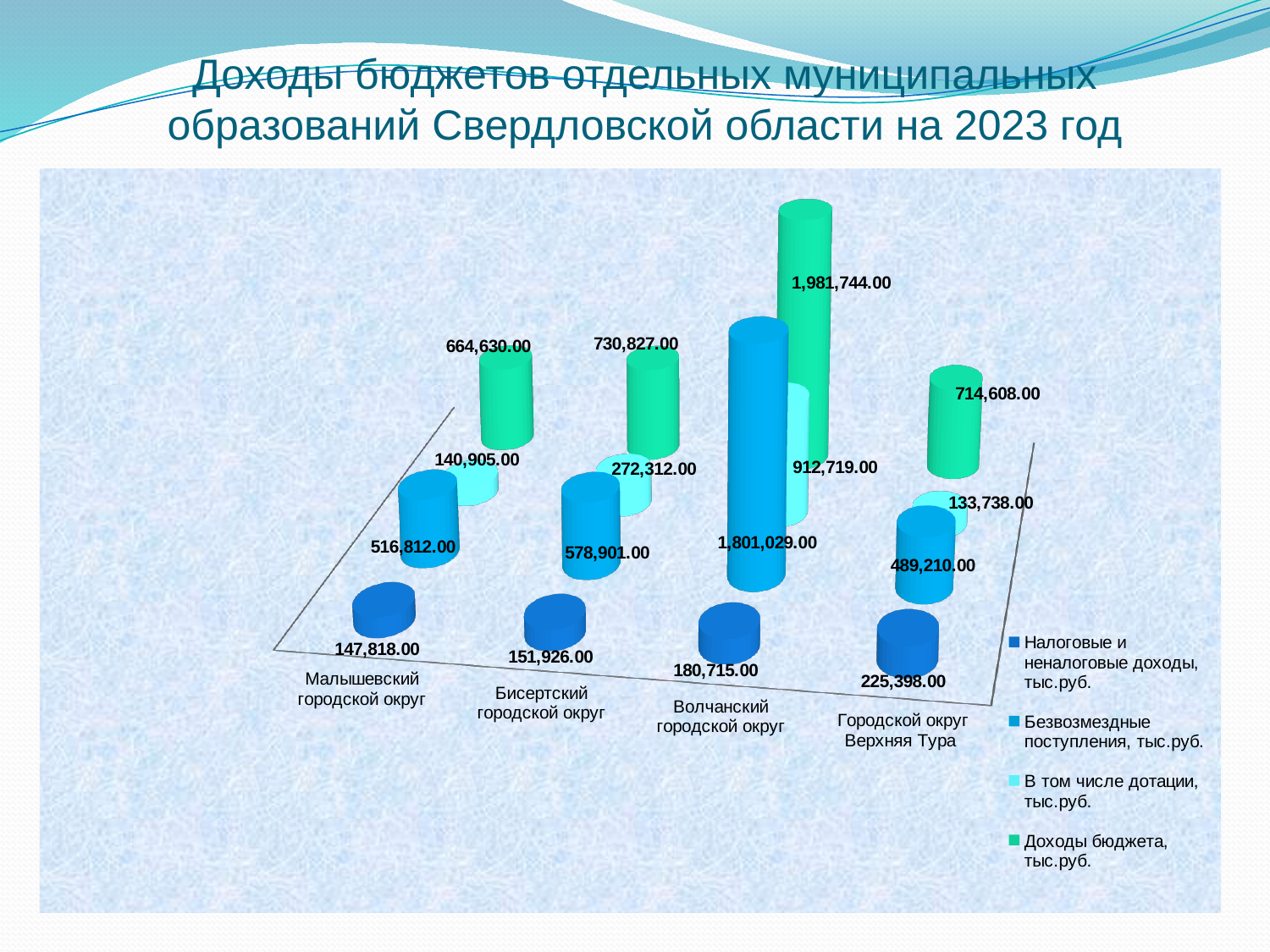
What is the value of Безвозмездные поступления, тыс.руб. for Городской округ Верхняя Тура? 489,210.00 What kind of chart is shown on the slide? Bar chart How many municipalities are shown on the x axis? 4 What is the value of Доходы бюджета, тыс.руб. for Волчанский городской округ? 1,981,744.00 What is the value of В том числе дотации, тыс.руб. for Бисертский городской округ? 272,312.00 What is the difference between Доходы бюджета, тыс.руб. for Бисертский городской округ and Малышевский городской округ? 66,197.00 Which is larger: В том числе дотации, тыс.руб. for Малышевский городской округ or for Городской округ Верхняя Тура? Малышевский городской округ Which municipality has the lowest Налоговые и неналоговые доходы, тыс.руб.? Малышевский городской округ What is the value of Налоговые и неналоговые доходы, тыс.руб. for Малышевский городской округ? 147,818.00 How many series does the legend list? 4 Which legend entry is shown in green? Доходы бюджета, тыс.руб. Which municipality has the highest Доходы бюджета, тыс.руб.? Волчанский городской округ